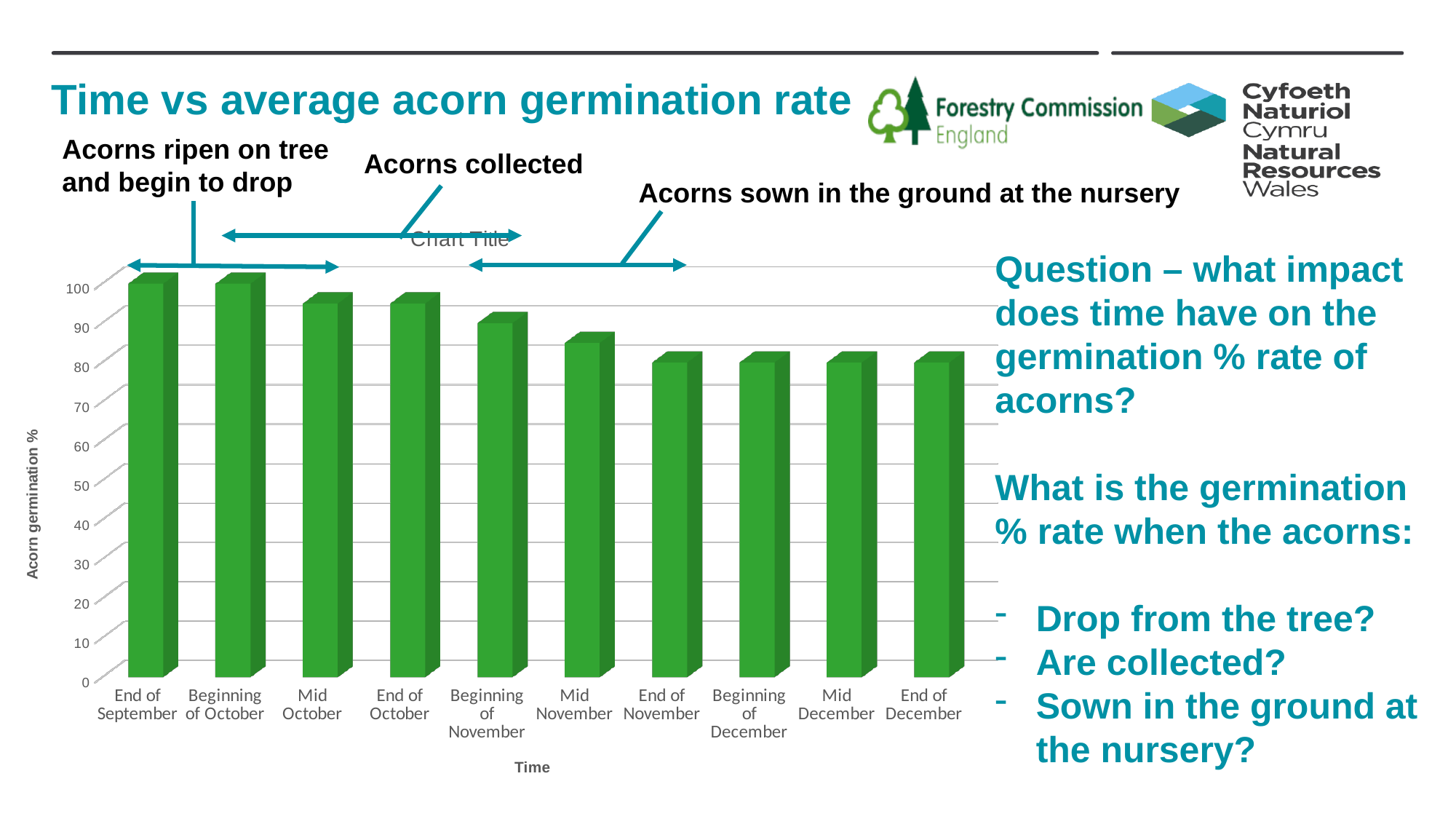
Is the acorn germination % for Beginning of December greater or less than 90? less What is the label on the horizontal axis of the chart? Time Is the acorn germination % for Mid November greater or less than 90? less Is the acorn germination % for Mid October greater or less than 90? greater What kind of chart is shown on the slide? bar chart Which has the higher acorn germination %, Mid October or Mid November? Mid October Which has the higher acorn germination %, End of September or End of December? End of September Do the germination values rise or fall as time moves from End of September to End of December? fall What is the label on the vertical axis of the chart? Acorn germination % How many time-period categories are plotted on the x axis of the chart? 10